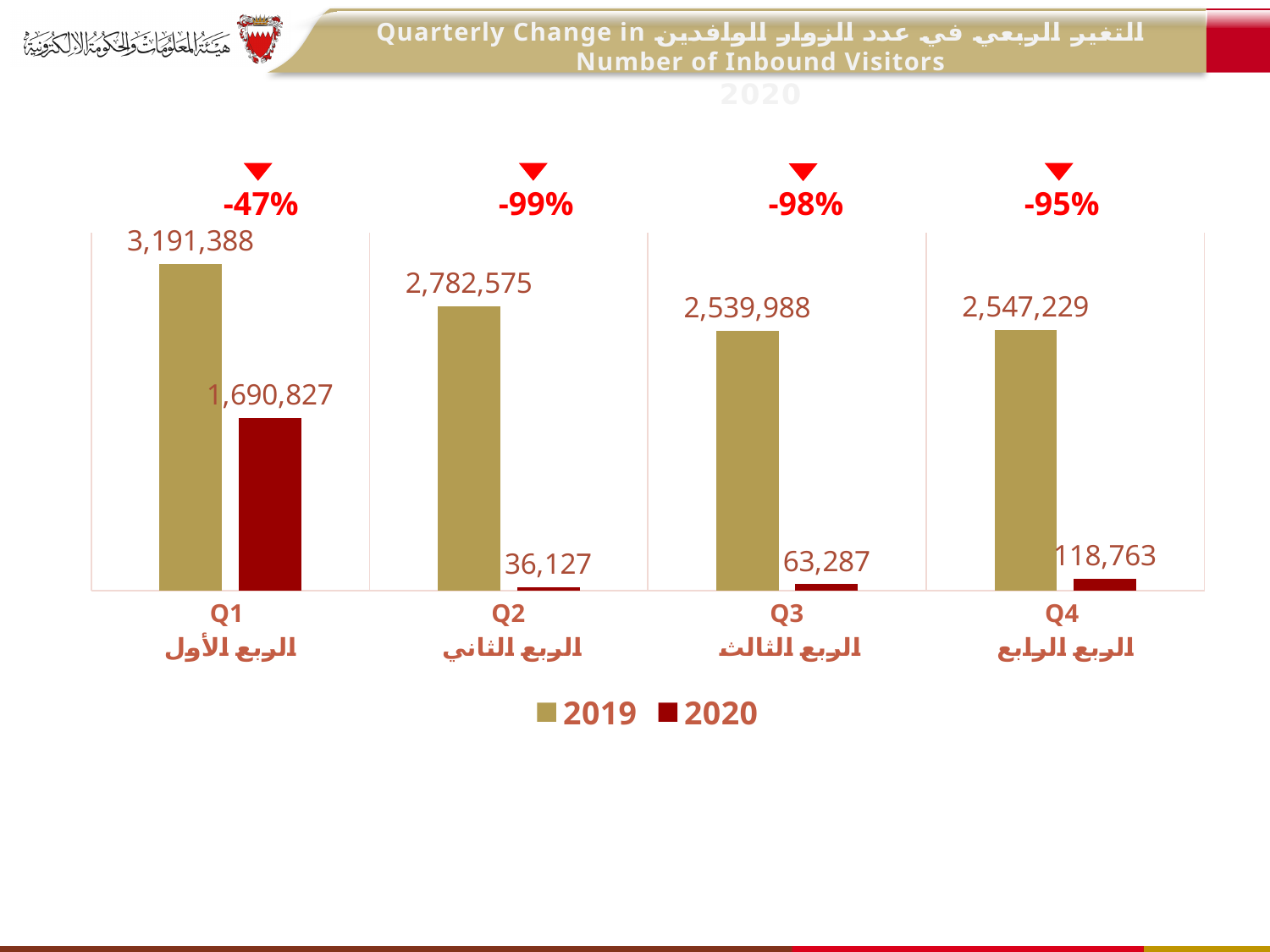
What is the value for 2019 in Q3? 2,539,988 Which quarter has the lowest value for 2020? Q2 What is the difference between the 2019 and 2020 values in Q1? 1,500,561 How many quarters are shown on the x axis? 4 What is the difference between the 2020 values in Q4 and Q3? 55,476 What is the number of inbound visitors for 2019 in Q1? 3,191,388 How many series does the legend list? 2 What percentage change is shown above Q2? -99% Which is larger, the 2020 value in Q1 or the 2020 value in Q4? Q1 What is the number of inbound visitors for 2020 in Q2? 36,127 Which quarter has the highest value for 2019? Q1 What is the value for 2020 in Q4? 118,763